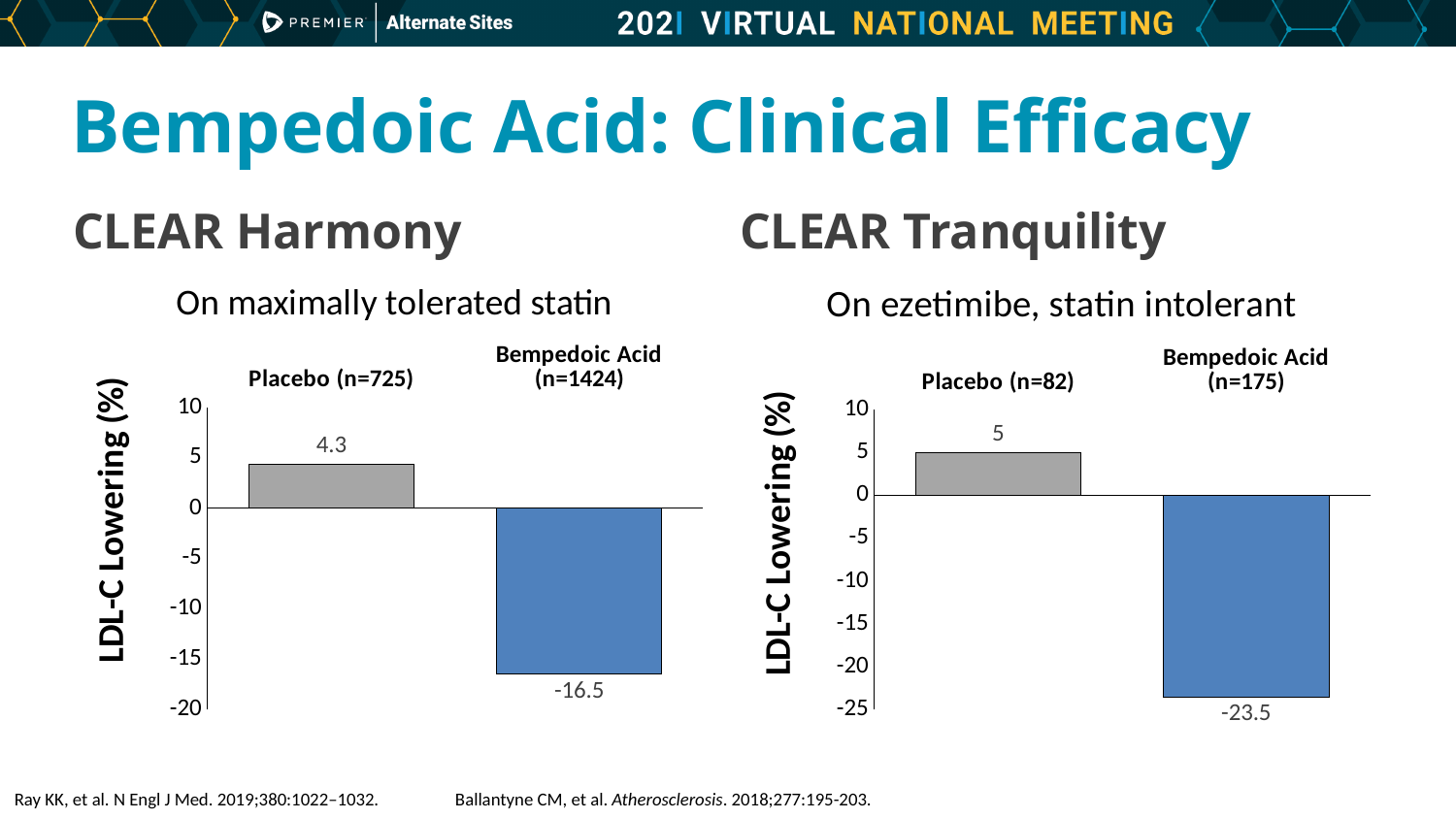
In the CLEAR Harmony chart, what is the LDL-C lowering value for Bempedoic Acid (n=1424)? -16.5 Is the Bempedoic Acid value in the CLEAR Tranquility chart greater or less than -20? less What is the y-axis label on the CLEAR Harmony chart? LDL-C Lowering (%) In the CLEAR Harmony chart, which group has the lower LDL-C lowering value? Bempedoic Acid (n=1424) What type of chart is used for CLEAR Tranquility? Bar chart In the CLEAR Tranquility chart, what is the LDL-C lowering value for Placebo (n=82)? 5 In the CLEAR Tranquility chart, what is the difference between the Placebo value and the Bempedoic Acid value? 28.5 In the CLEAR Tranquility chart, which group has the higher LDL-C lowering value? Placebo (n=82) In the CLEAR Harmony chart, what is the difference between the Placebo value and the Bempedoic Acid value? 20.8 In the CLEAR Harmony chart, what is the LDL-C lowering value for Placebo (n=725)? 4.3 How many bars are shown in the CLEAR Harmony chart? 2 In the CLEAR Tranquility chart, what is the LDL-C lowering value for Bempedoic Acid (n=175)? -23.5